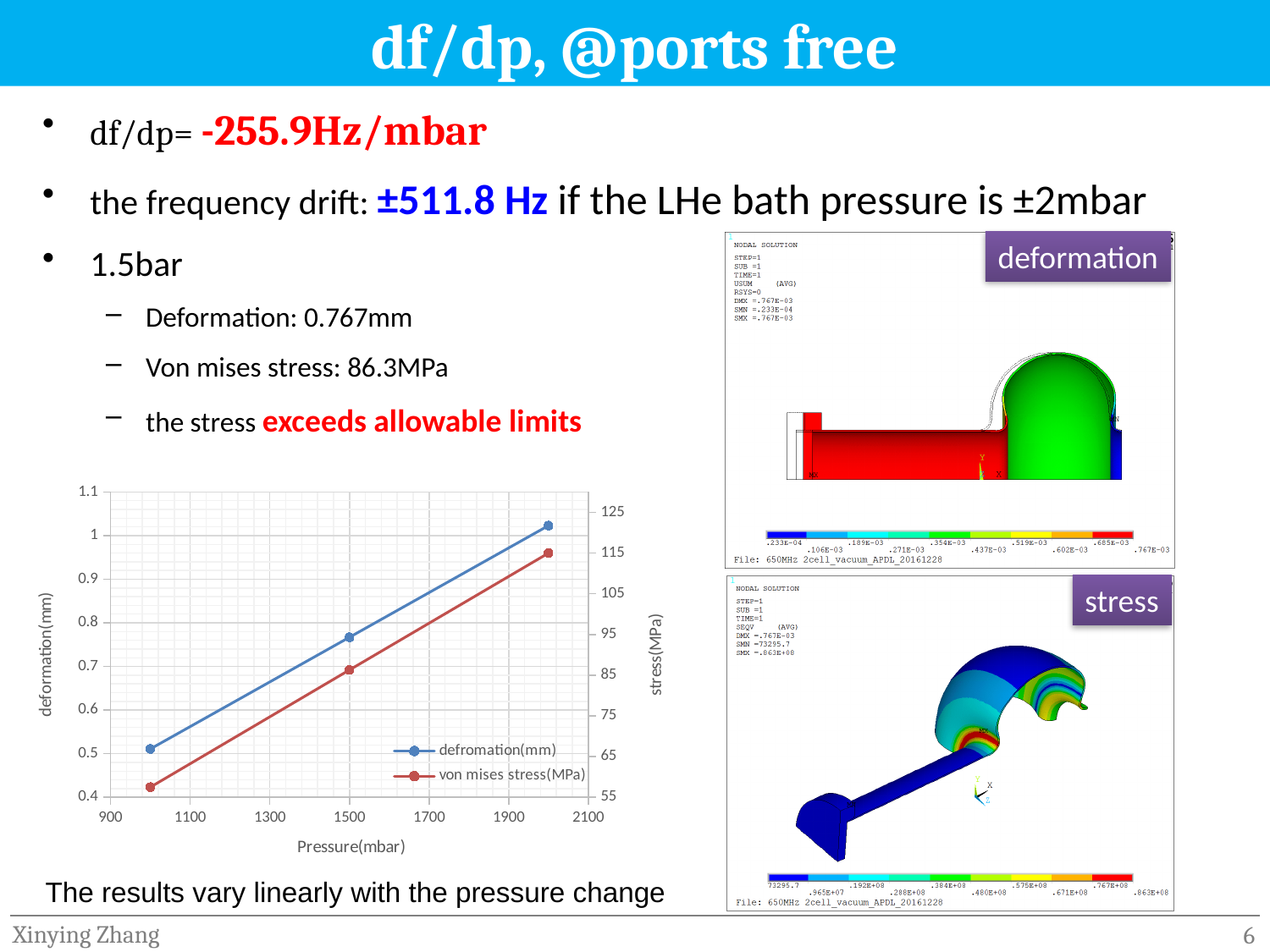
Does the von mises stress rise or fall as pressure increases along the x axis? rise At which pressure is the von mises stress lowest? 1000 mbar Is the von mises stress value at 1000 mbar greater or less than 65 MPa? less What kind of chart is shown on the slide? line chart How many data points are plotted for the defromation(mm) series? 3 Is the deformation value at 1500 mbar greater or less than 0.7 mm? greater Is the deformation value at 2000 mbar greater or less than 0.9 mm? greater At which pressure is the deformation highest? 2000 mbar What is the title of the x axis of the chart? Pressure(mbar) How many series does the chart legend list? 2 Does the deformation rise or fall as pressure increases along the x axis? rise